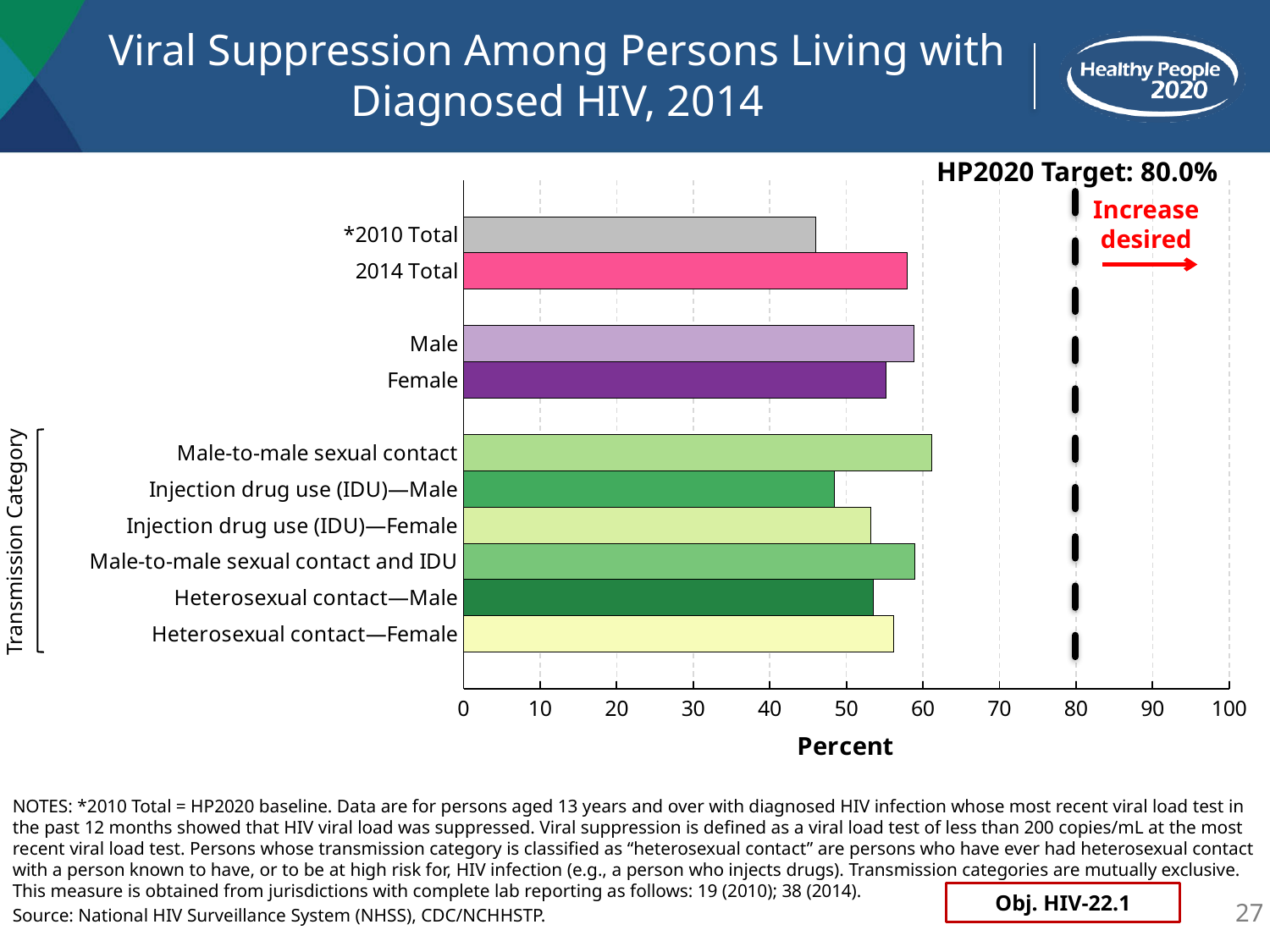
Which is larger, the value for Male-to-male sexual contact or the value for Injection drug use (IDU)—Male? Male-to-male sexual contact Is the value for Male-to-male sexual contact greater or less than 50? greater Which is larger, the value for 2014 Total or the value for *2010 Total? 2014 Total What kind of chart is shown on the slide? bar chart Is the value for Heterosexual contact—Female greater or less than 60? less Is the value for *2010 Total greater or less than 50? less Which is larger, the value for Male or the value for Female? Male What is the HP2020 Target shown on the chart? 80.0% What is the label of the horizontal axis? Percent How many bars (categories) are plotted in the chart? 10